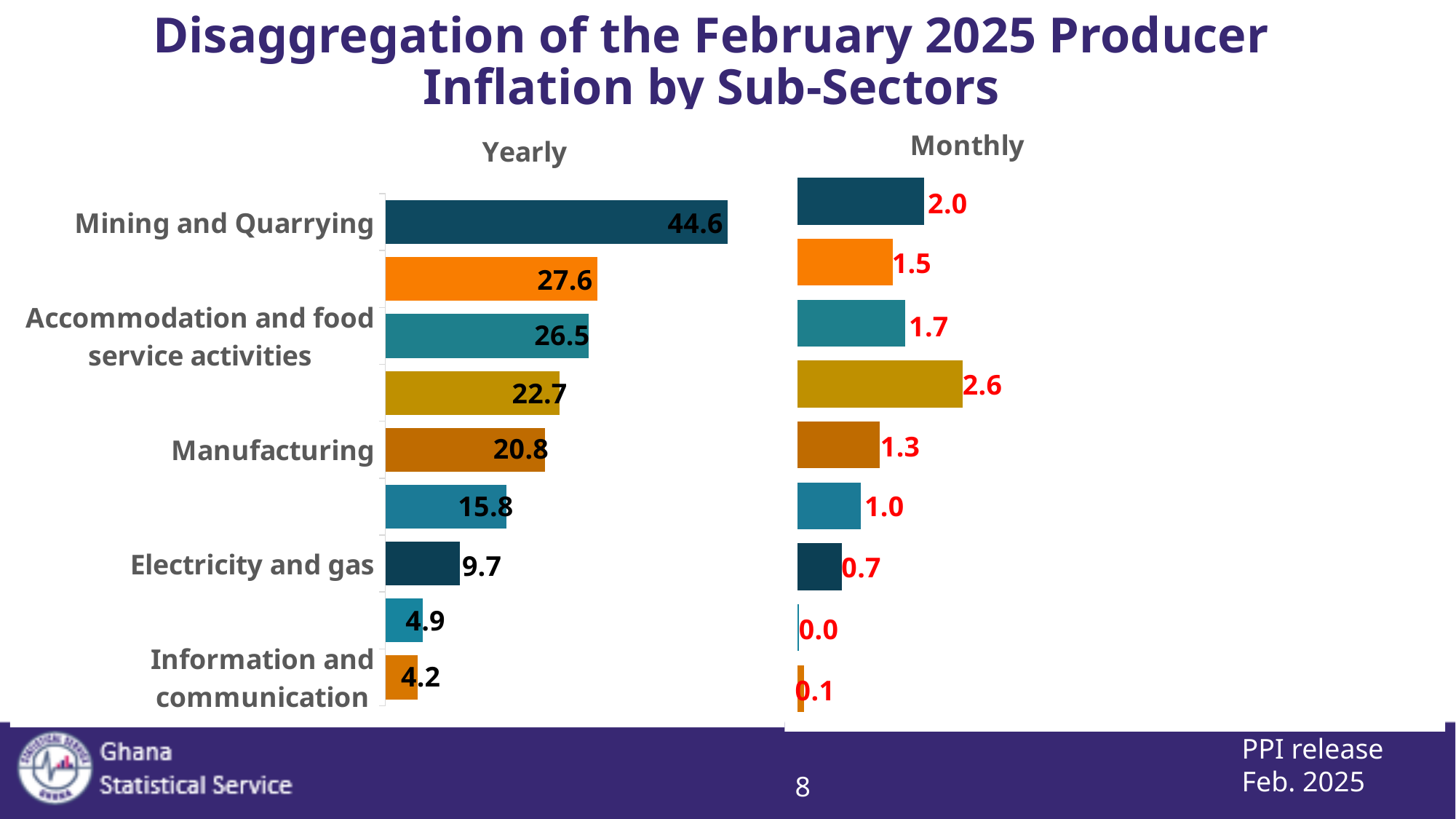
In the Yearly chart, which sub-sector has the lowest value? Information and communication In the Yearly chart, what is the value for Accommodation and food service activities? 26.5 What kind of chart is the Monthly chart? Bar chart In the Yearly chart, what is the value for Mining and Quarrying? 44.6 In the Yearly chart, what is the difference between Mining and Quarrying and Manufacturing? 23.8 How many bars are plotted in the Yearly chart? 9 In the Monthly chart, what is the value for Information and communication? 0.1 In the Monthly chart, which is larger: Accommodation and food service activities or Manufacturing? Accommodation and food service activities In the Yearly chart, what is the value for Electricity and gas? 9.7 In the Yearly chart, which sub-sector has the highest value? Mining and Quarrying In the Monthly chart, what is the difference between Mining and Quarrying and Electricity and gas? 1.3 In the Monthly chart, what is the value for Manufacturing? 1.3